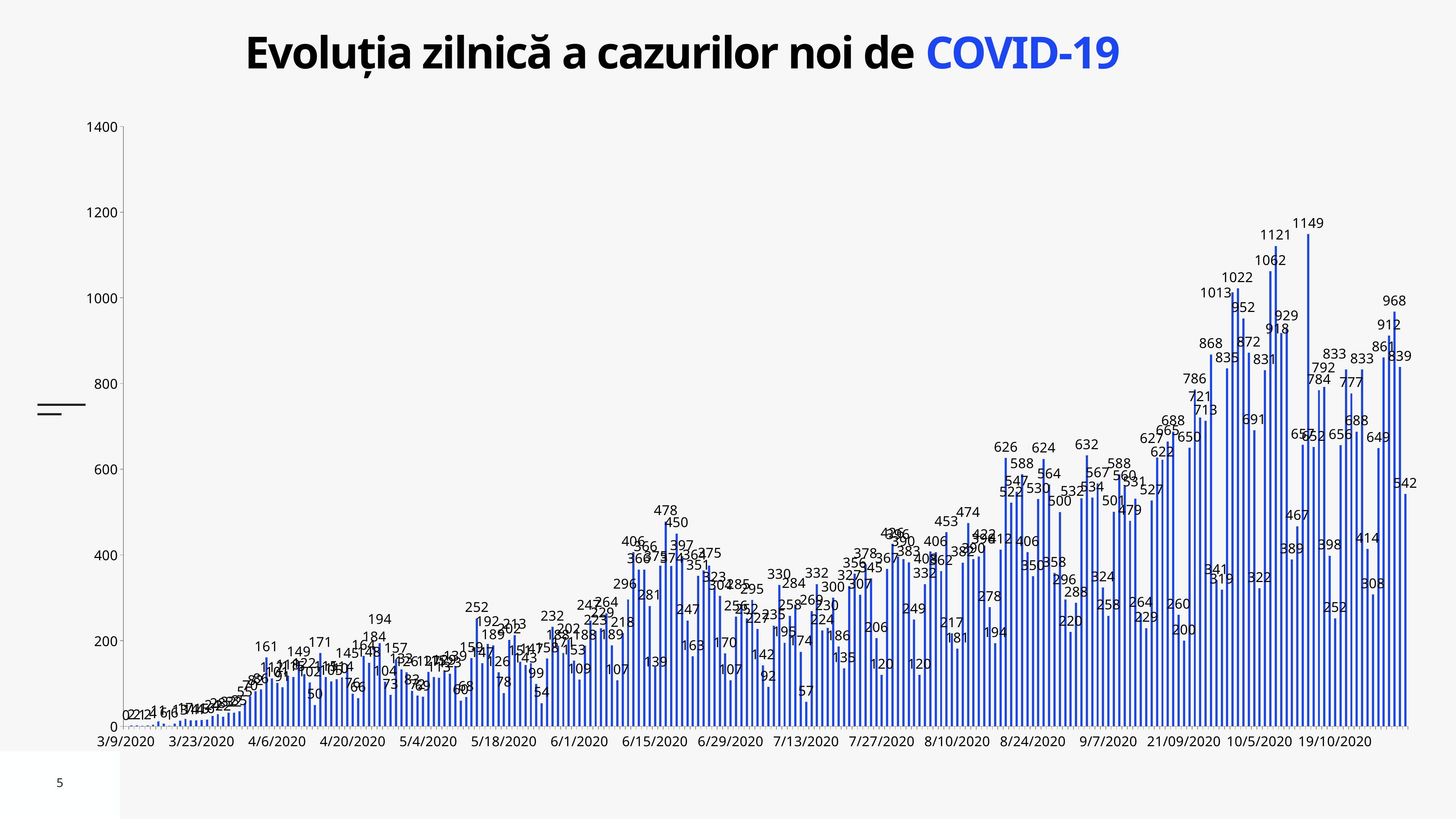
What is the maximum value shown on the y axis? 1400 Which is larger, the bar labelled 1062 or the bar labelled 1022? 1062 What kind of chart is shown on the slide? bar chart Is the highest bar in the chart greater or less than 1000? greater What is the difference between the bars labelled 968 and 912? 56 What is the value of the last bar on the right of the chart? 542 What is the difference between the two highest labelled values, 1149 and 1121? 28 What is the title of the chart? Evoluția zilnică a cazurilor noi de COVID-19 Is the value of the last bar on the right greater or less than 600? less Overall, do the daily values rise or fall from March 2020 to October 2020? rise What is the first date label on the x axis? 3/9/2020 What is the highest daily value shown in the chart? 1149